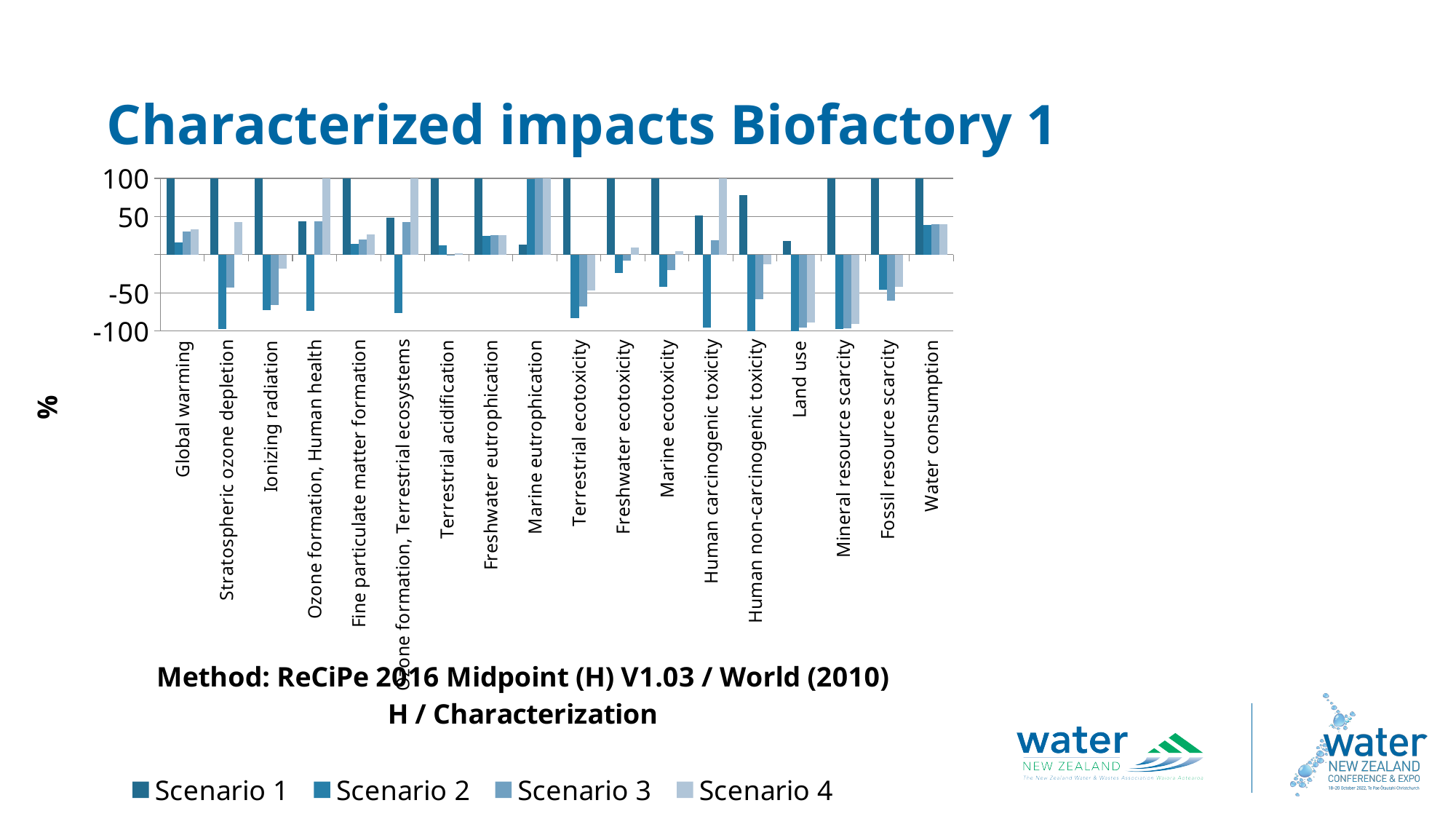
Is the value for Scenario 1 for Land use greater or less than 50? less Is the value for Scenario 2 for Stratospheric ozone depletion greater or less than -50? less What is the value for Scenario 1 for Global warming? 100 What kind of chart is shown on the slide? bar chart Which scenario has the lowest value for Fossil resource scarcity? Scenario 3 How many series does the legend list? 4 Which is larger: the Scenario 2 value for Water consumption or the Scenario 2 value for Terrestrial ecotoxicity? Water consumption What is the label on the y axis? % Is the value for Scenario 1 for Human non-carcinogenic toxicity greater or less than 50? greater How many impact categories are shown along the x axis? 18 Which scenario has the highest value for Global warming? Scenario 1